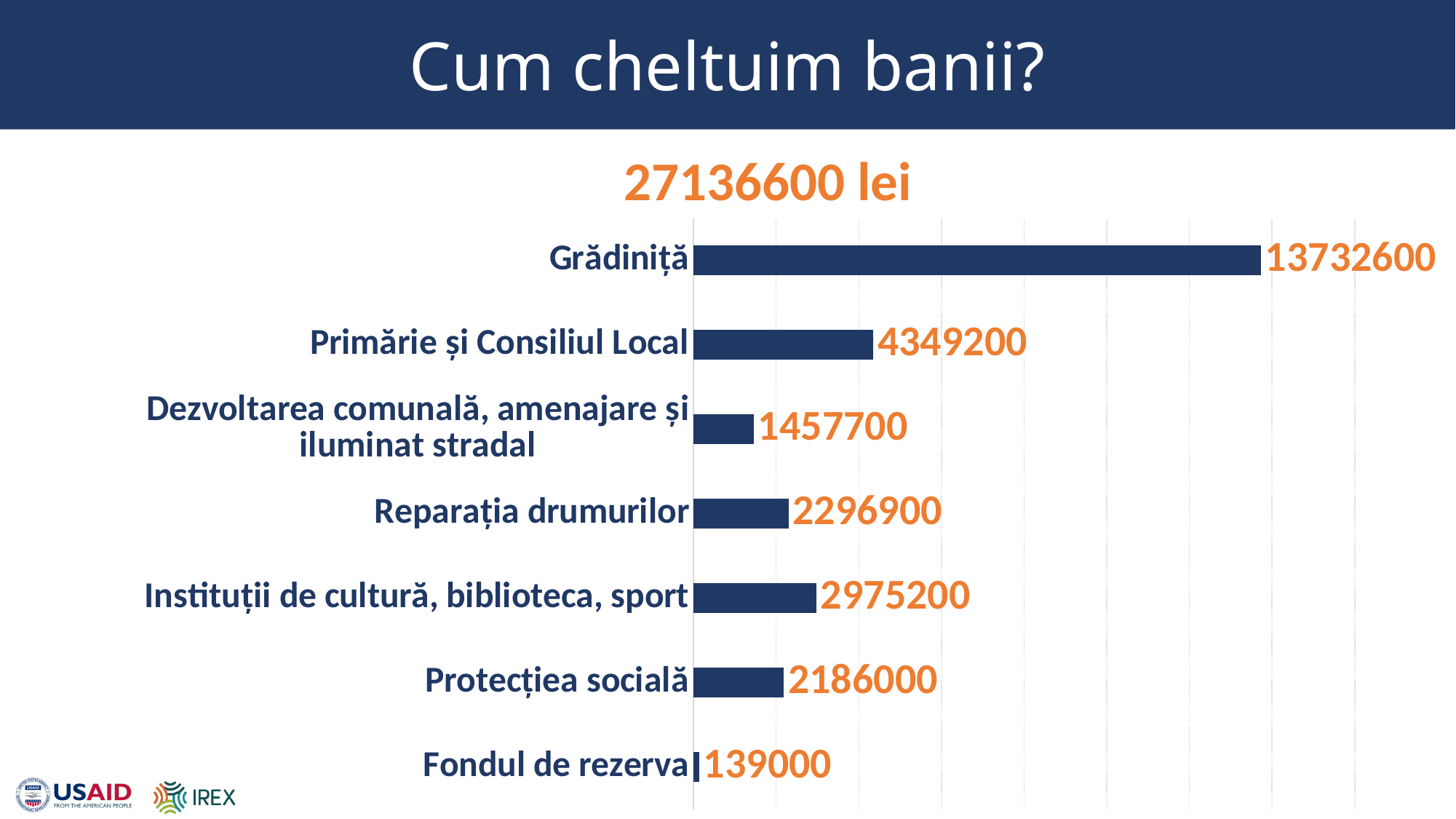
What is the difference between the values for Grădiniță and Primărie și Consiliul Local? 9383400 What kind of chart is shown on the slide? Bar chart How many categories are shown in the chart? 7 What is the difference between the values for Instituții de cultură, biblioteca, sport and Reparația drumurilor? 678300 Which category has the highest value? Grădiniță What is the value for Primărie și Consiliul Local? 4349200 What is the value for Grădiniță? 13732600 Which category has the lowest value? Fondul de rezerva What is the value for Reparația drumurilor? 2296900 What is the value for Fondul de rezerva? 139000 Which is larger: the value for Protecțiea socială or the value for Instituții de cultură, biblioteca, sport? Instituții de cultură, biblioteca, sport